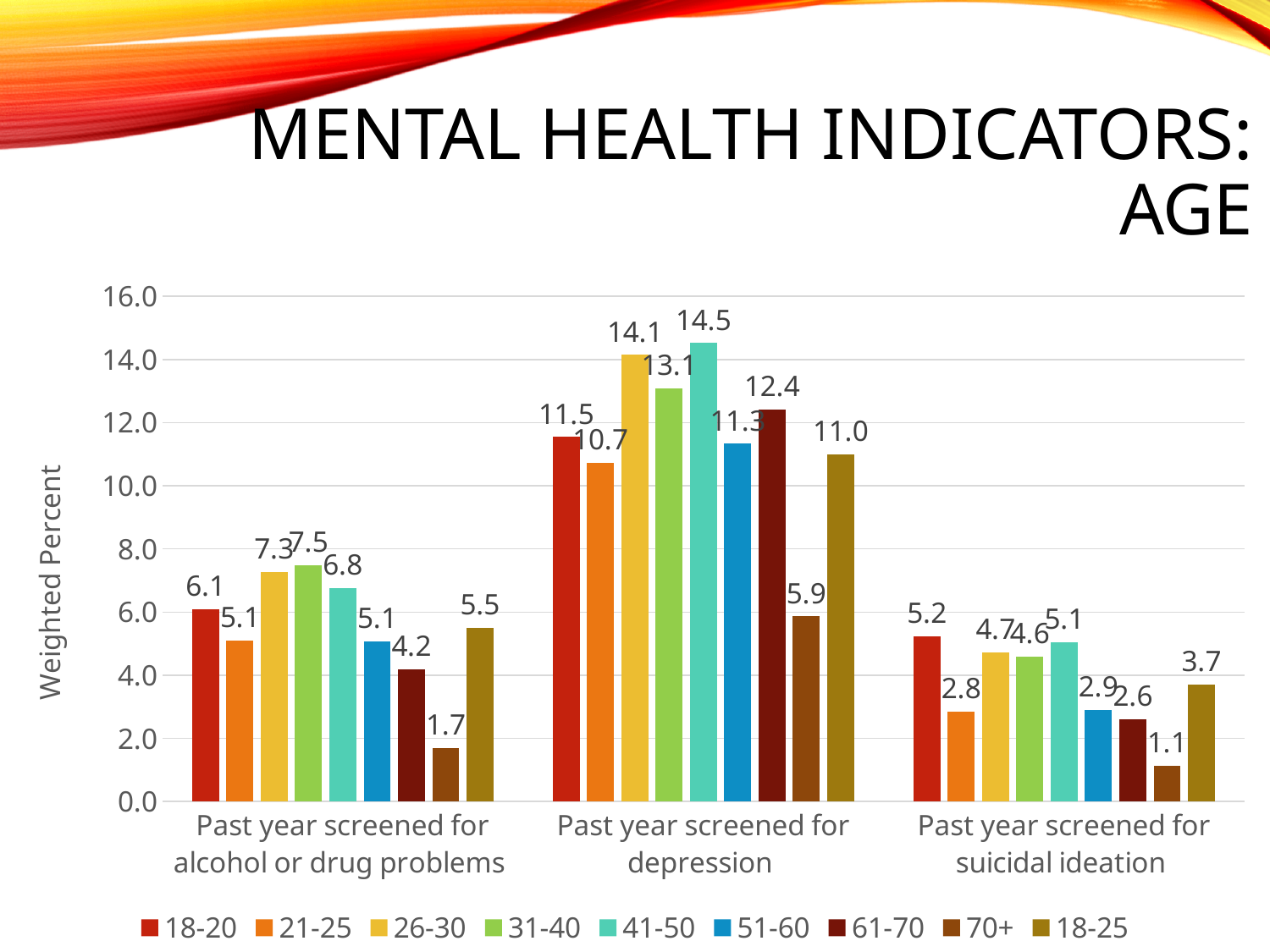
What is the difference between the 26-30 and 70+ values for 'Past year screened for depression'? 8.2 How many categories are shown on the x axis? 3 What is the value for the 70+ age group for 'Past year screened for alcohol or drug problems'? 1.7 What is the value for the 18-25 age group for 'Past year screened for suicidal ideation'? 3.7 What is the value for the 41-50 age group for 'Past year screened for depression'? 14.5 What is the label of the y axis? Weighted Percent For 'Past year screened for alcohol or drug problems', which is larger: the value for 18-20 or the value for 61-70? 18-20 Which age group has the lowest value for 'Past year screened for suicidal ideation'? 70+ What kind of chart is shown on the slide? Bar chart How many series does the legend list? 9 Is the value for the 61-70 age group for 'Past year screened for depression' greater or less than 12.0? greater Which age group has the highest value for 'Past year screened for depression'? 41-50